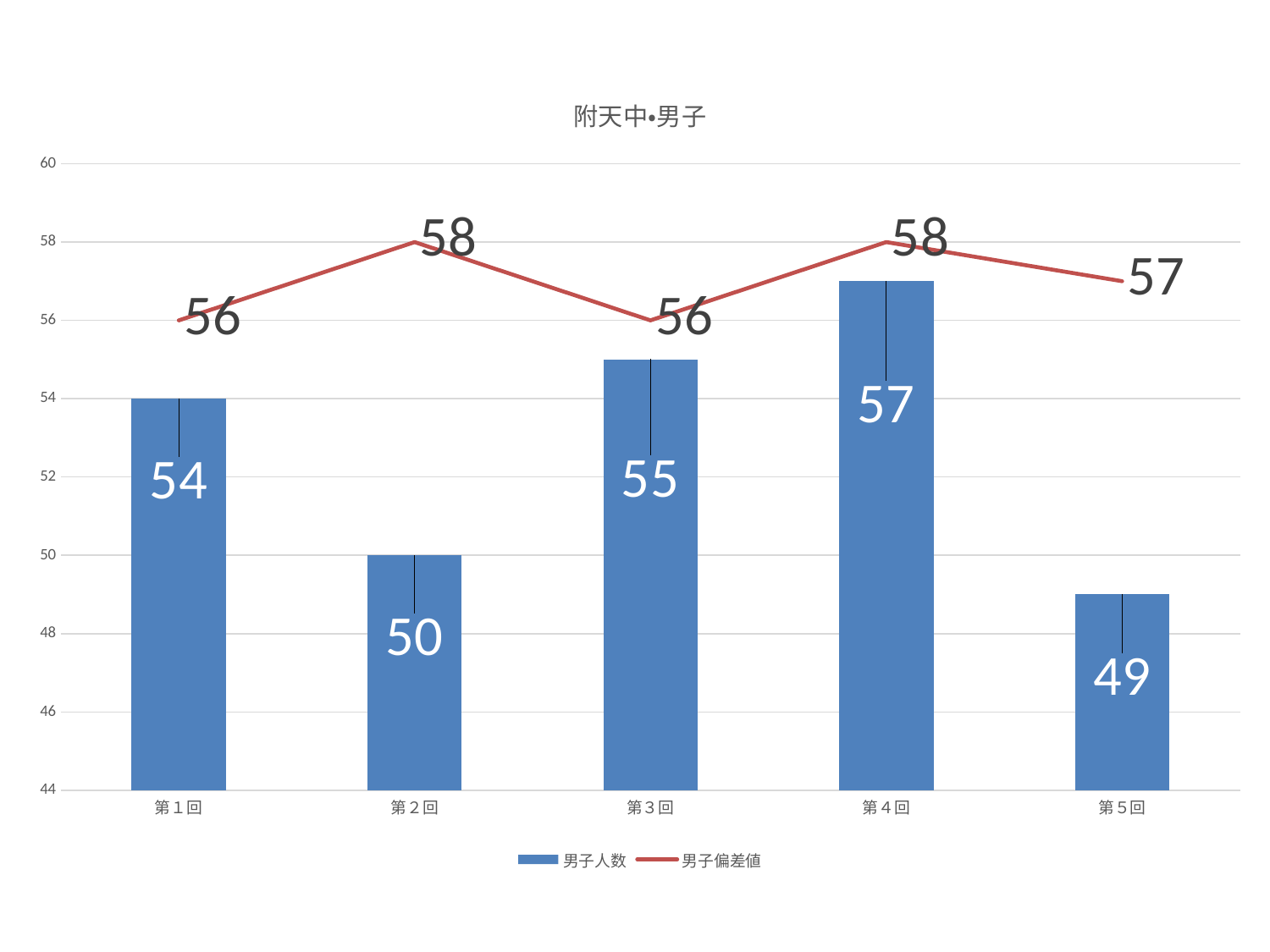
What is the 男子偏差値 value for 第５回? 57 Does the 男子人数 rise or fall from 第４回 to 第５回? fall How many series does the legend list? 2 Which round has the lowest 男子人数? 第５回 Which round has the highest 男子人数? 第４回 Which is larger, the 男子偏差値 for 第２回 or for 第３回? 第２回 Is the 男子人数 value for 第１回 greater or less than 52? greater What kind of chart is this? Combined bar and line chart How many rounds are shown on the x axis? 5 What is the title of the chart? 附天中•男子 What is the 男子人数 value for 第３回? 55 What is the difference in 男子人数 between 第４回 and 第２回? 7